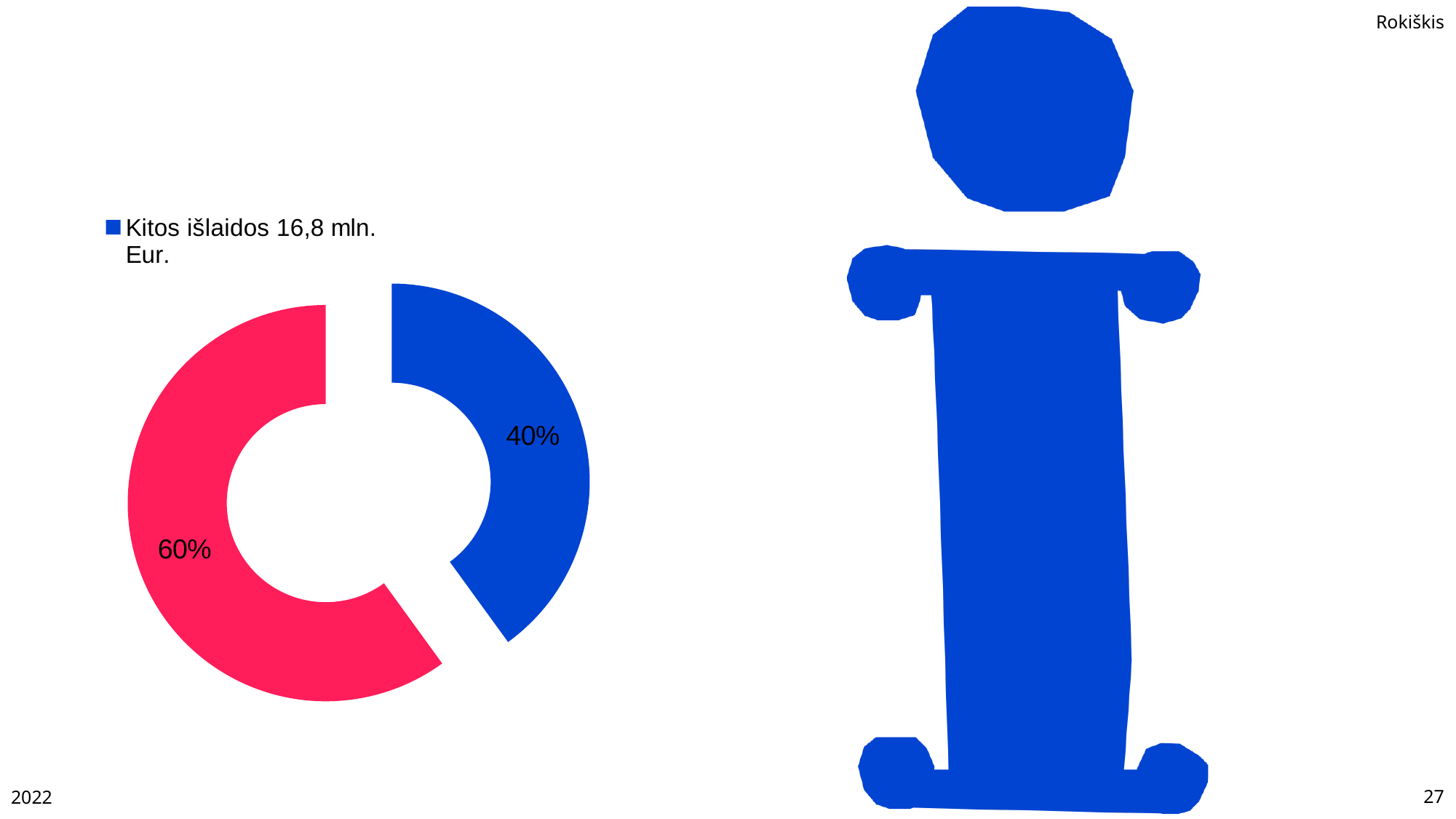
What percentage is printed on the red slice of the doughnut chart? 60% Which slice of the doughnut chart is the largest? the red slice (60%) How many entries does the legend of the doughnut chart list? 1 What percentage is printed on the blue slice of the doughnut chart? 40% What share of the doughnut chart does the slice "Kitos išlaidos 16,8 mln. Eur." take? 40% How many slices does the doughnut chart have? 2 By how many percentage points does the red slice exceed the blue slice in the doughnut chart? 20 percentage points What colour is the slice for "Kitos išlaidos 16,8 mln. Eur." in the doughnut chart? blue Which slice of the doughnut chart is the smallest? the blue slice, Kitos išlaidos 16,8 mln. Eur. (40%) What is the legend entry shown for the doughnut chart? Kitos išlaidos 16,8 mln. Eur. What kind of chart is shown on the slide? doughnut (pie) chart Which is larger in the doughnut chart, the red slice or the blue slice? the red slice